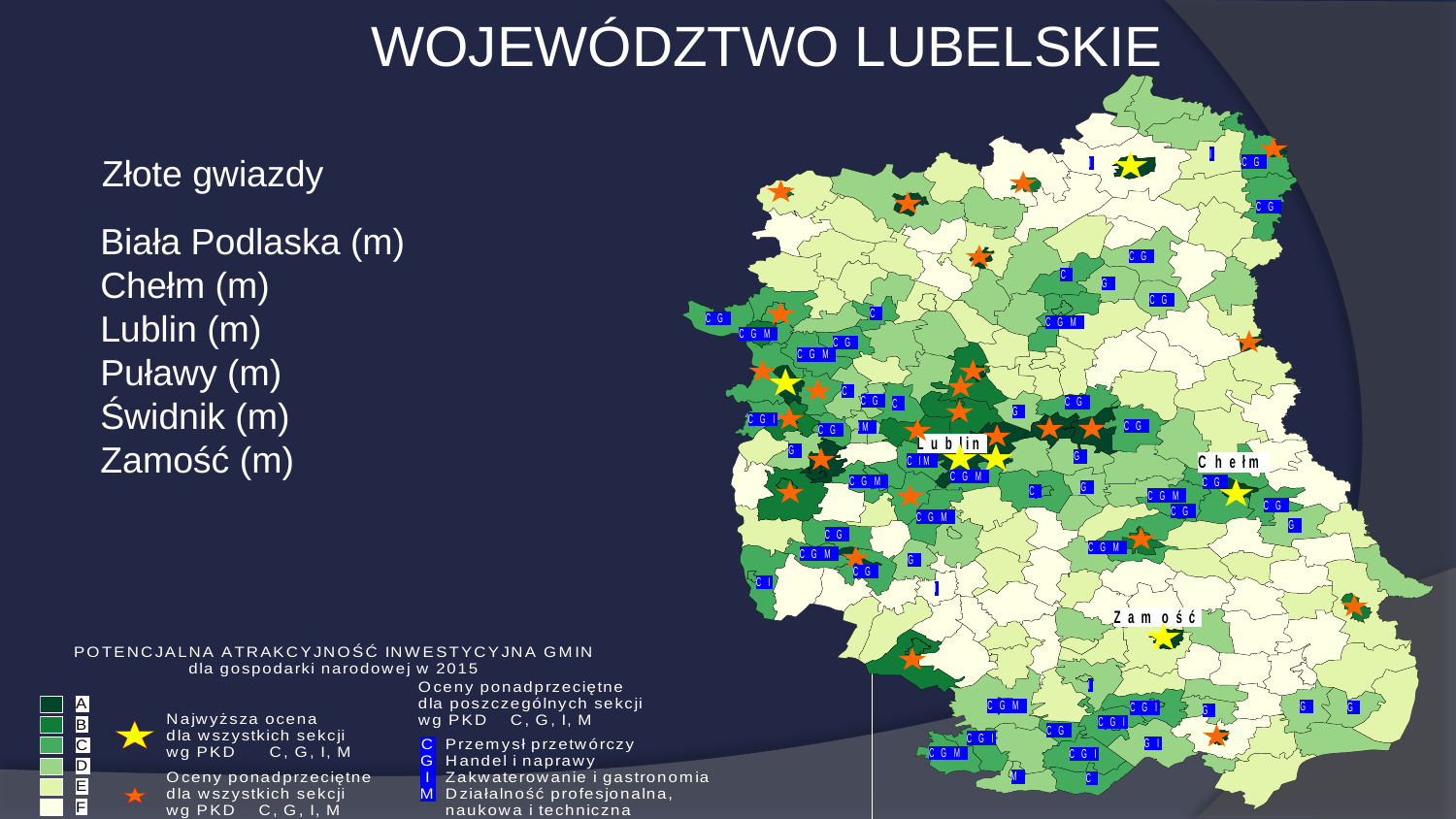
How many municipalities are listed under 'Złote gwiazdy' on the slide? 6 What kind of chart is shown on the slide? map Which municipality is listed last under 'Złote gwiazdy'? Zamość (m) For which year does the map show potential investment attractiveness of municipalities? 2015 According to the legend, what does the letter G stand for? Handel i naprawy How many classes (A to F) does the map legend list? 6 How many PKD sections (C, G, I, M) are listed in the legend? 4 Which municipality is listed first under 'Złote gwiazdy'? Biała Podlaska (m)